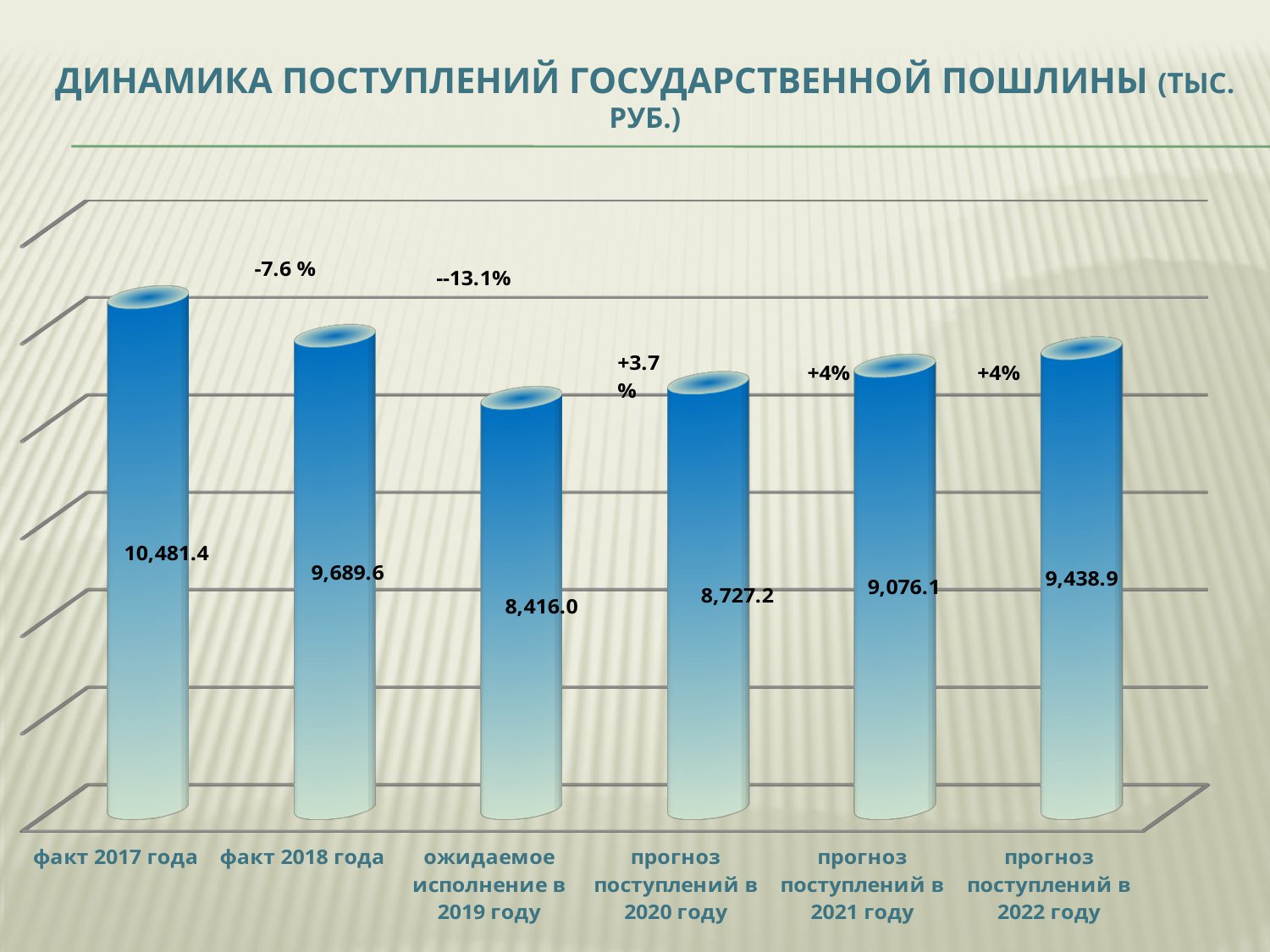
How many categories are shown on the chart? 6 What is the value for факт 2017 года? 10,481.4 What is the difference between the values for прогноз поступлений в 2022 году and ожидаемое исполнение в 2019 году? 1,022.9 What is the value for ожидаемое исполнение в 2019 году? 8,416.0 Which category has the lowest value? ожидаемое исполнение в 2019 году What is the difference between the values for факт 2017 года and факт 2018 года? 791.8 What is the value for прогноз поступлений в 2022 году? 9,438.9 What is the value for прогноз поступлений в 2020 году? 8,727.2 What kind of chart is shown on the slide? bar chart Which is larger, the value for прогноз поступлений в 2021 году or the value for факт 2018 года? факт 2018 года From ожидаемое исполнение в 2019 году to прогноз поступлений в 2022 году, do the values rise or fall? rise Which category has the highest value? факт 2017 года